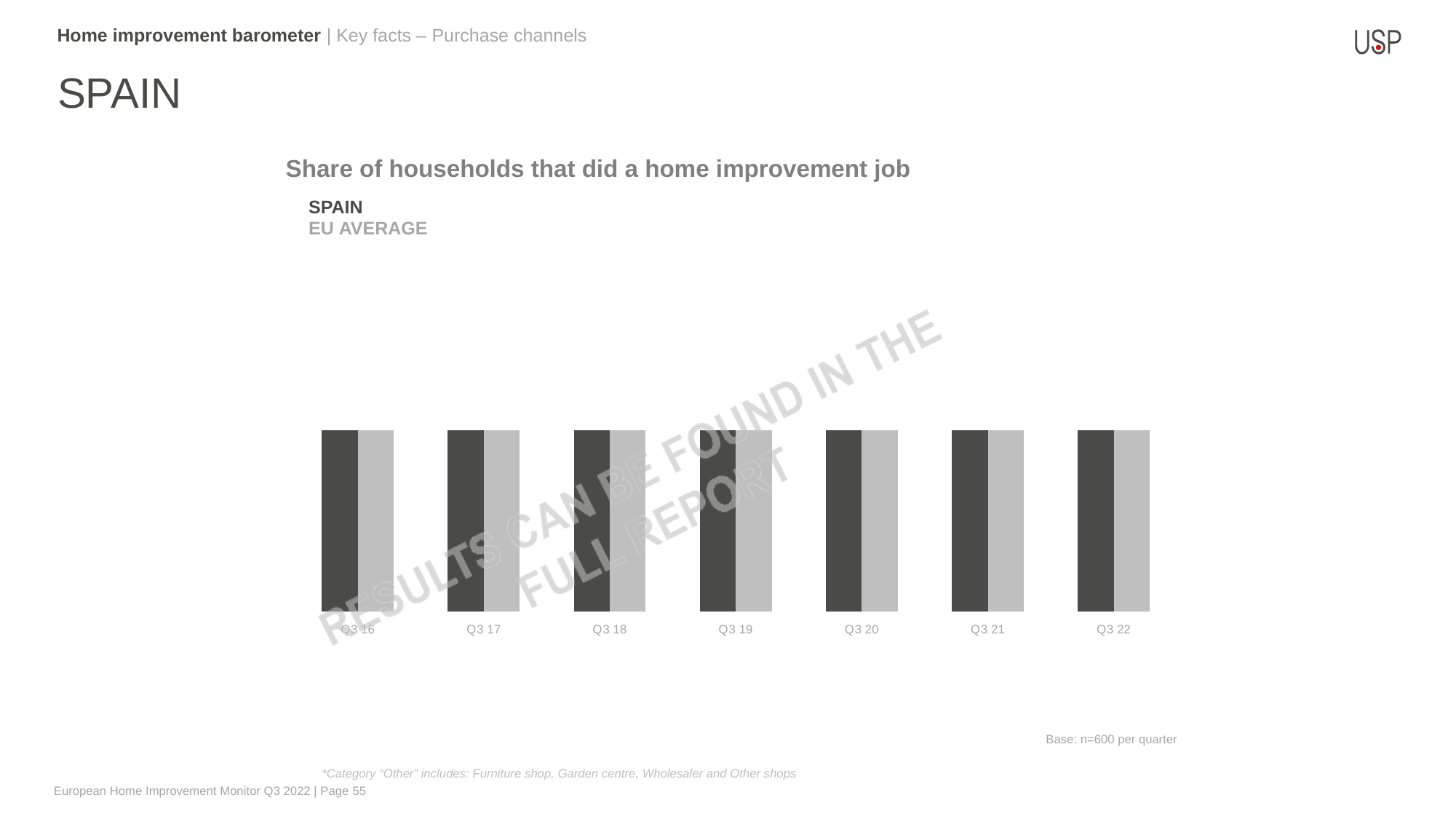
What kind of chart is shown on the slide? bar chart What is the last category label on the x axis of the chart? Q3 22 What is the first category label on the x axis of the chart? Q3 16 Which two series are listed in the chart's legend? SPAIN and EU AVERAGE What is the title of the chart? Share of households that did a home improvement job How many quarters are shown along the x axis of the chart? 7 How many series does the chart's legend list? 2